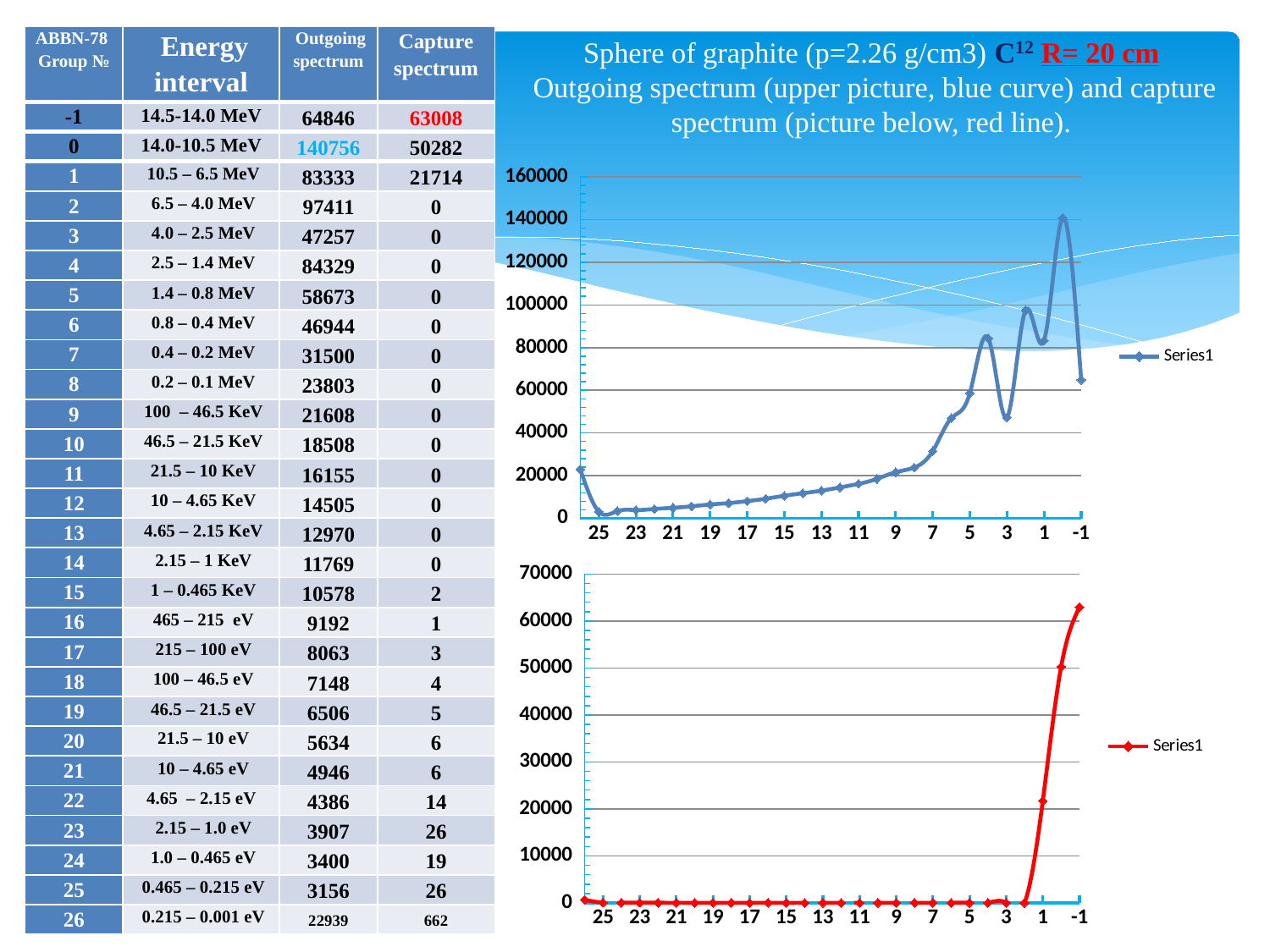
In the upper chart, is the value at group 0 greater or less than 120000? greater In the lower chart, is the value at group -1 greater or less than 50000? greater In the upper chart, is the value at group 3 greater or less than 60000? less In the upper chart, which has the larger value: group 0 or group 1? group 0 In the lower chart, do the values rise or fall as the x axis moves from group 3 toward group -1? rise What is the legend entry shown next to the upper chart? Series1 In the upper chart (outgoing spectrum), at which group number on the x axis does the curve reach its highest point? 0 How many series does the legend of the lower chart list? 1 What kind of chart is the upper chart on the slide? line chart In the lower chart (capture spectrum), at which group number on the x axis does the curve reach its highest point? -1